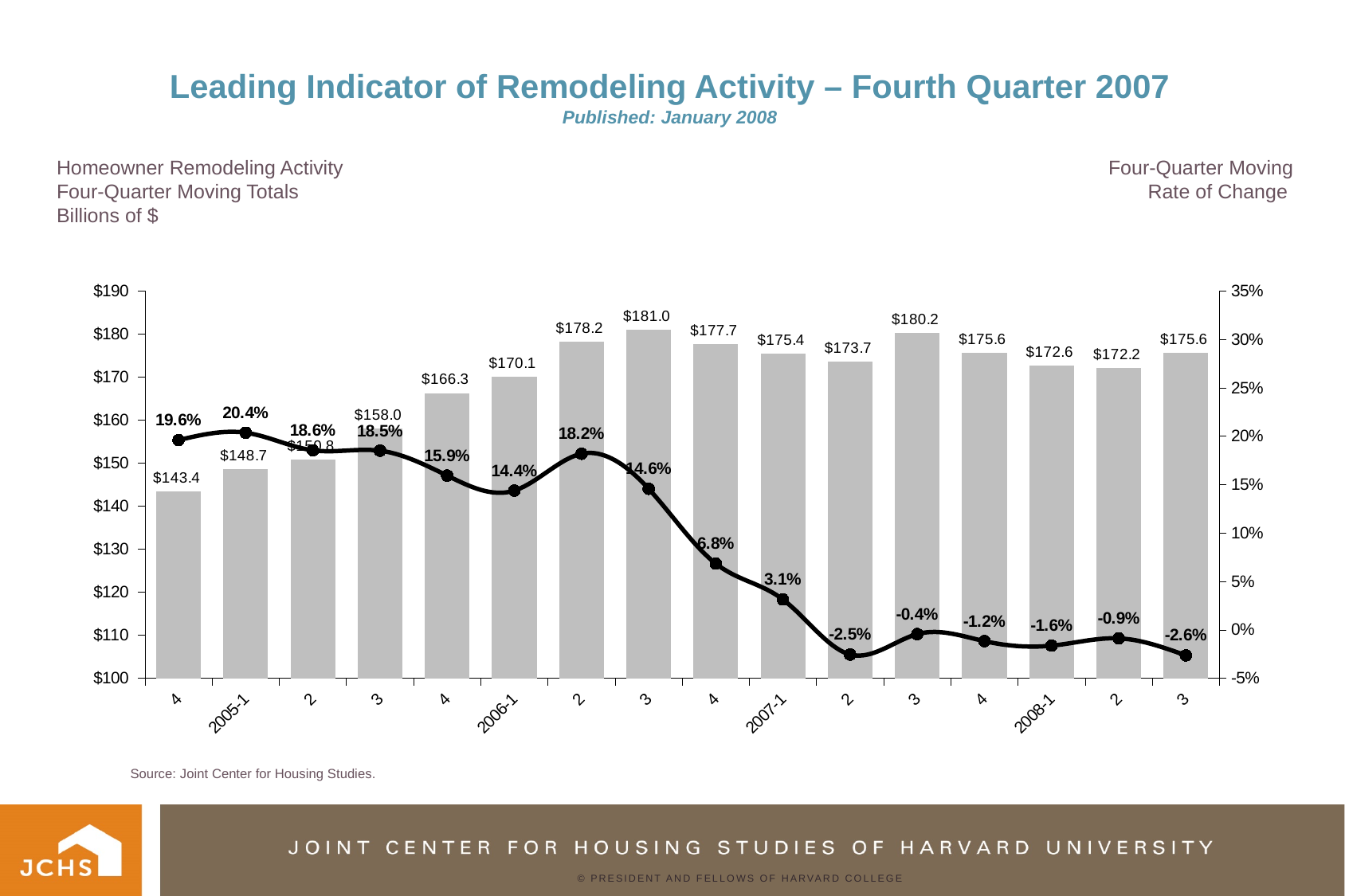
What is the four-quarter moving total for 2008-1? $172.6 What is the four-quarter moving rate of change for 2007-1? 3.1% Does the four-quarter moving rate of change line generally rise or fall from left to right? Fall How many quarters (bars) are plotted on the chart? 16 Which is larger, the four-quarter moving total for 2007-1 or for 2007-2? 2007-1 What is the difference between the four-quarter moving totals for 2006-3 ($181.0) and 2007-3 ($180.2)? $0.8 What is the lowest four-quarter moving total shown on the chart? $143.4 What kind of chart is shown on the slide? Combination bar and line chart What is the four-quarter moving total for the third quarter of 2006 (the bar labeled 3 after 2006-1)? $181.0 Which quarter has the highest four-quarter moving total bar? 2006-3 ($181.0) What is the lowest four-quarter moving rate of change shown on the chart? -2.6% Which quarter has the highest four-quarter moving rate of change? 2005-1 (20.4%)